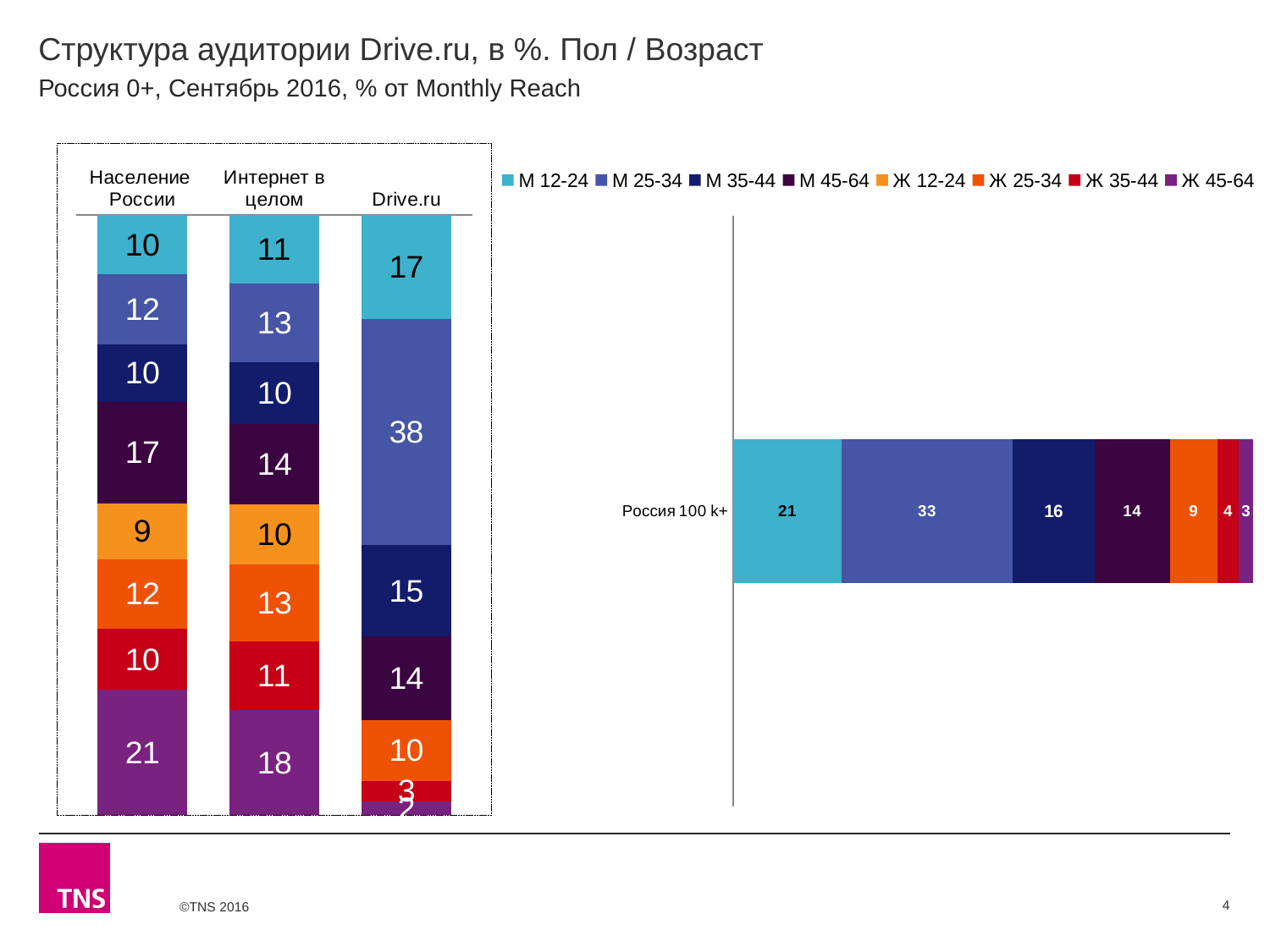
What is the category label of the single bar in the right chart? Россия 100 k+ What kind of chart is the left chart? Stacked bar chart How many bars are in the left chart? 3 How many series does the legend list? 8 In the right chart (Россия 100 k+), what is the value for М 35-44? 16 In the right chart (Россия 100 k+), which series has the largest segment? М 25-34 In the left chart, what is the value for М 45-64 in the Население России bar? 17 In the left chart, which bar has the larger Ж 45-64 value: Население России or Интернет в целом? Население России In the left chart, what is the value for М 25-34 in the Drive.ru bar? 38 In the left chart, what is the difference between the М 25-34 value for Drive.ru and the М 25-34 value for Интернет в целом? 25 In the right chart (Россия 100 k+), what is the value for М 12-24? 21 In the left chart, what is the value for Ж 45-64 in the Интернет в целом bar? 18